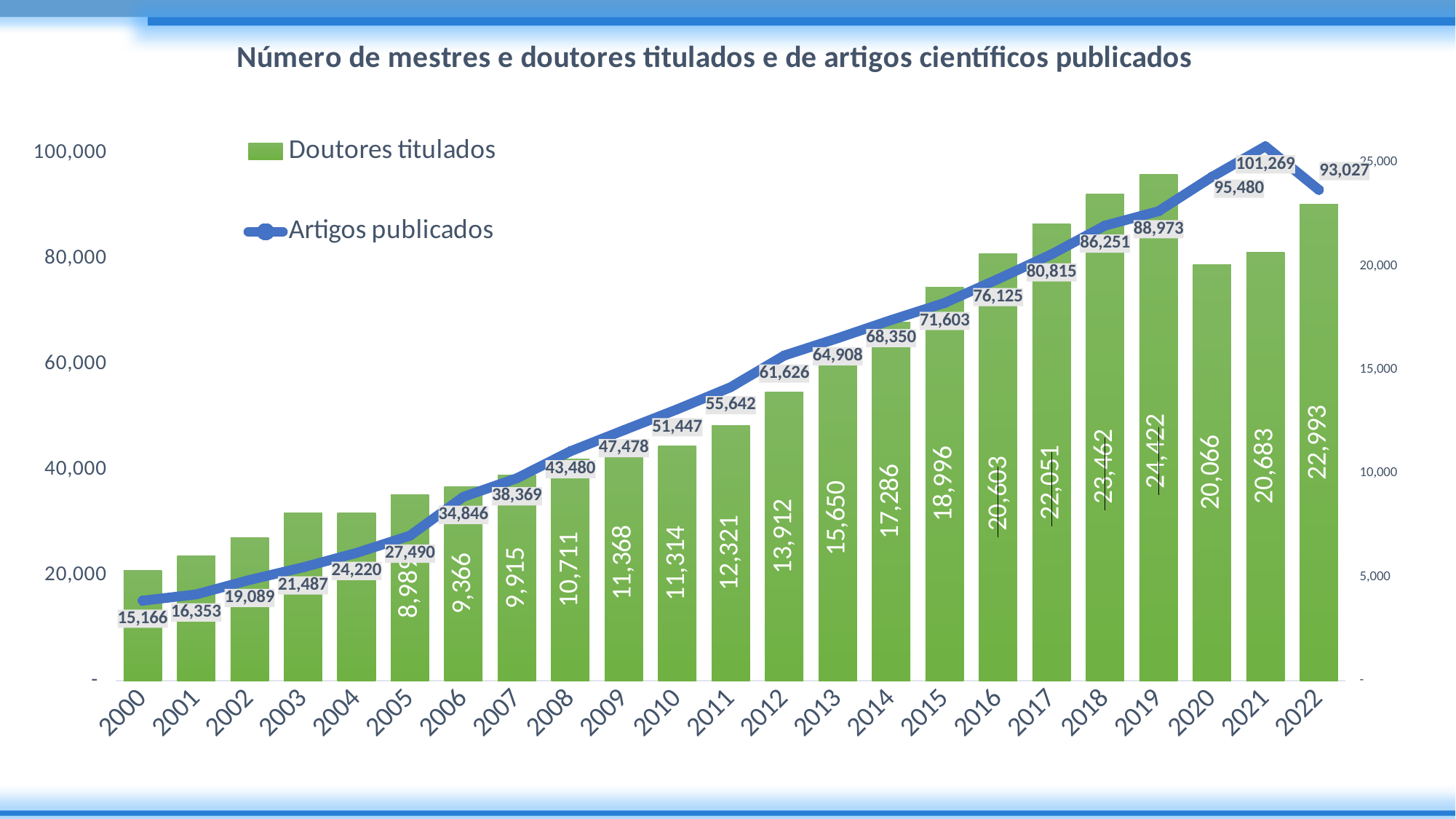
Is the value of Doutores titulados in 2004 greater or less than 5,000 on the right axis? greater What is the value of Artigos publicados in 2000? 15,166 In which year is the number of Doutores titulados lowest? 2000 In which year is the number of Artigos publicados highest? 2021 By how much did Artigos publicados fall from 2021 to 2022? 8,242 Which year had more Doutores titulados, 2020 or 2021? 2021 How many series does the legend list? 2 In which year is the number of Doutores titulados highest? 2019 What is the difference in Doutores titulados between 2019 and 2020? 4,356 How many years are shown on the x axis? 23 What is the value of Artigos publicados in 2021? 101,269 How many Doutores titulados were there in 2019? 24,422